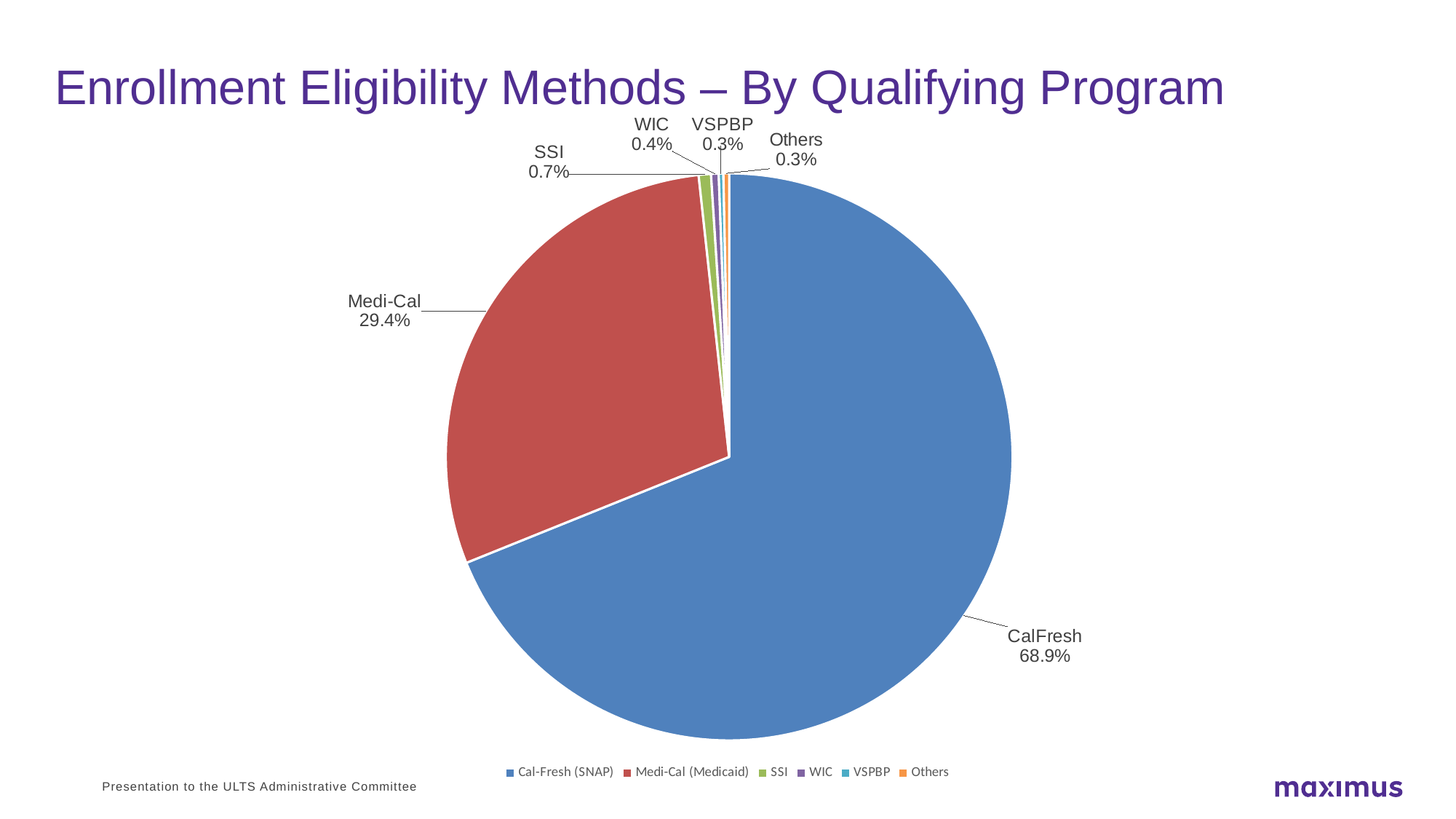
What is the title of the chart on the slide? Enrollment Eligibility Methods – By Qualifying Program What is the value shown for WIC? 0.4% Which slice is larger, SSI or WIC? SSI What kind of chart is shown on the slide? Pie chart How many slices does the pie chart have? 6 What share of the pie does CalFresh account for? 68.9% What colour is the Medi-Cal (Medicaid) slice in the pie chart? Red What is the value shown for SSI? 0.7% What share of the pie does Medi-Cal account for? 29.4% Which slice is larger, Medi-Cal or SSI? Medi-Cal What is the difference in percentage points between the CalFresh and Medi-Cal slices? 39.5 Which qualifying program has the largest slice of the pie? CalFresh